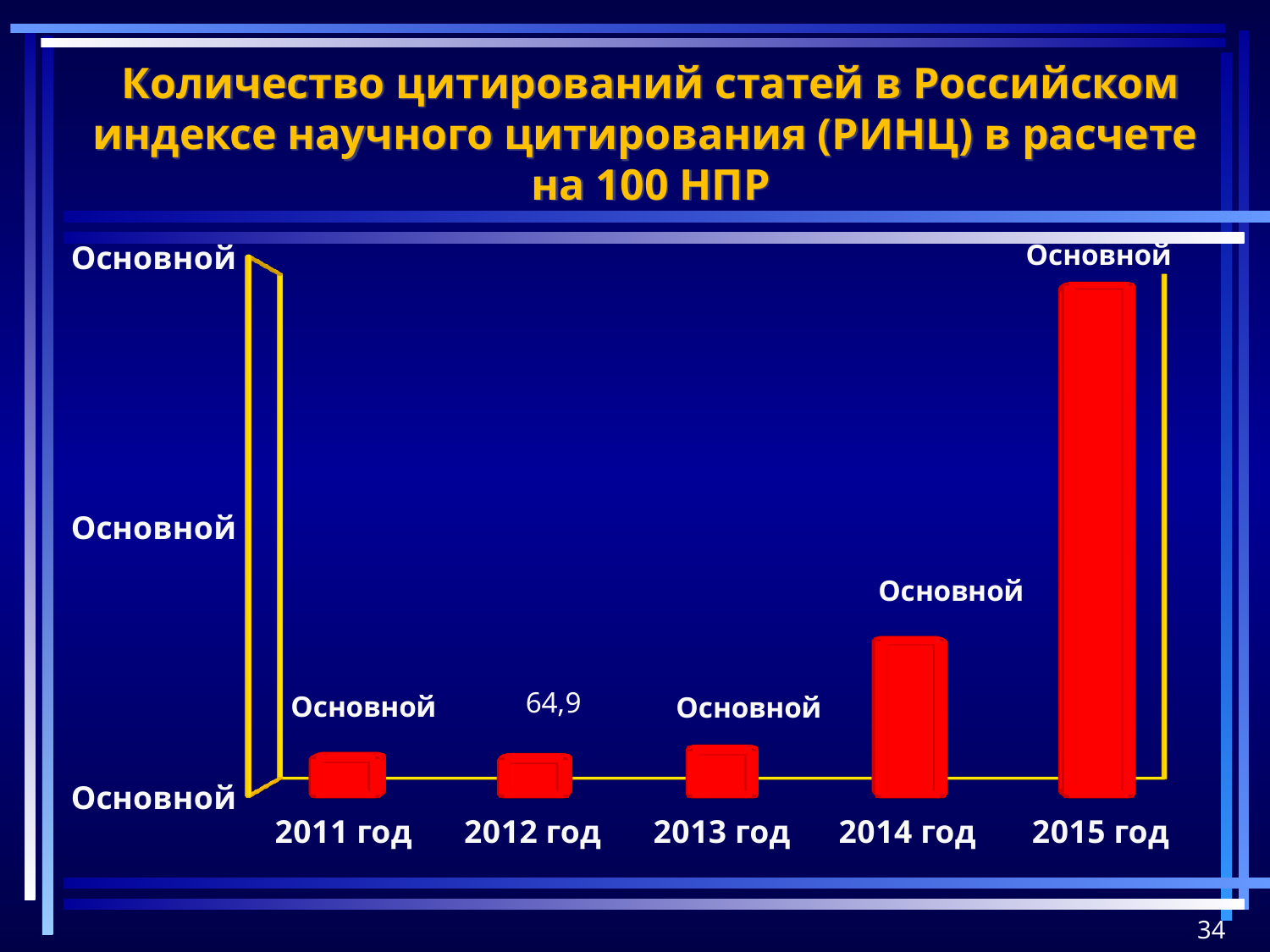
What is the title of the chart? Количество цитирований статей в Российском индексе научного цитирования (РИНЦ) в расчете на 100 НПР Which is larger, the value for 2011 год or the value for 2014 год? 2014 год Which year has the highest value? 2015 год How many years are shown on the x axis? 5 What colour are the bars in the chart? Red What kind of chart is shown on the slide? Bar chart What is the value for 2012 год? 64,9 Which is larger, the value for 2014 год or the value for 2015 год? 2015 год Which is larger, the value for 2013 год or the value for 2014 год? 2014 год Do the values generally rise or fall from 2011 год to 2015 год? Rise